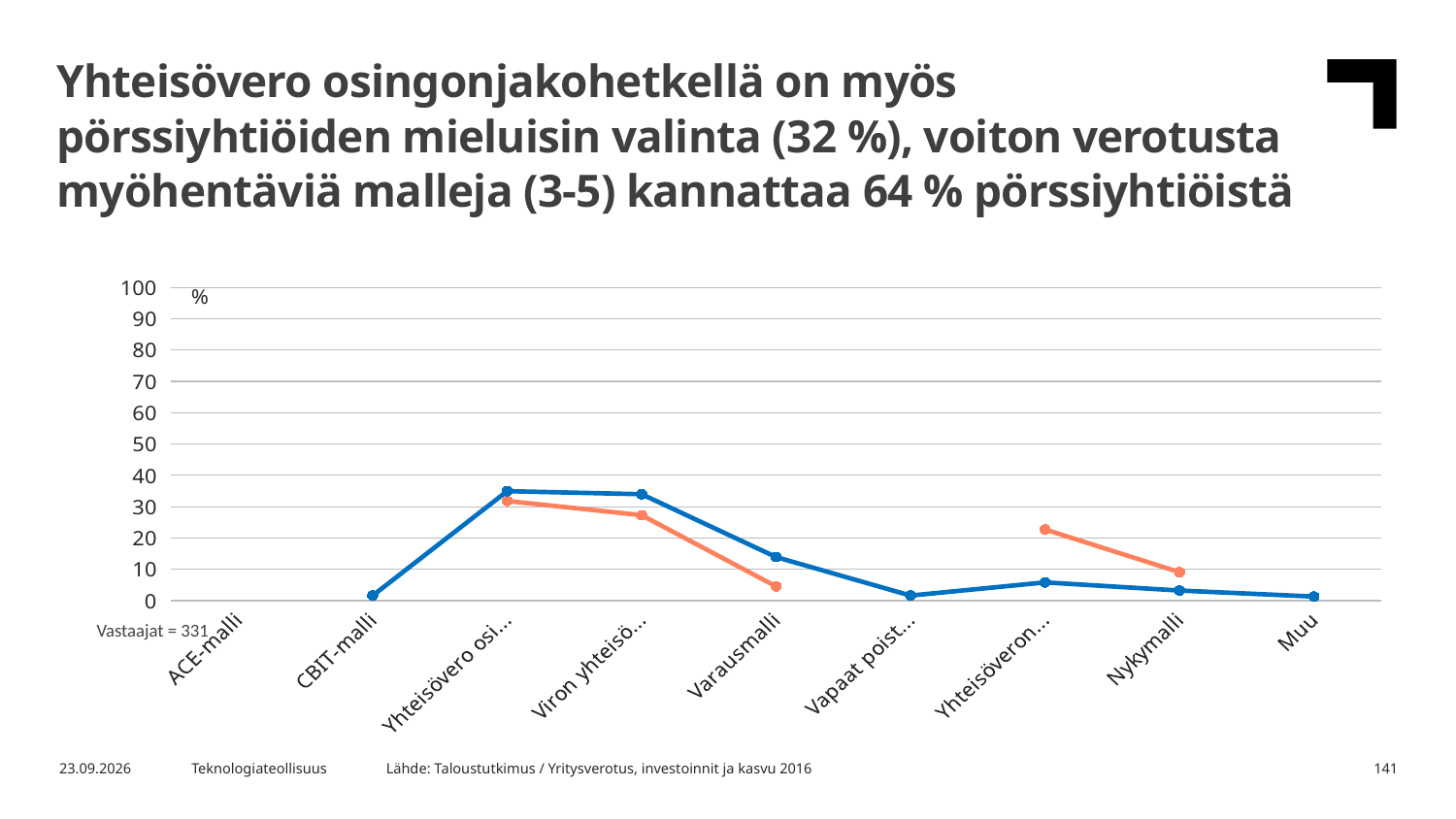
At which category does the orange line reach its highest value? Yhteisövero osi... Is the value of the orange line for Yhteisöveron... greater or less than 20? greater At Varausmalli, which line has the larger value, the blue line or the orange line? the blue line How many categories are shown on the x axis of the chart? 9 Is the value of the blue line for Varausmalli greater or less than 20? less Which is larger for the blue line: the value for Varausmalli or the value for Nykymalli? Varausmalli What kind of chart is shown on the slide? line chart Is the value of the orange line for Viron yhteisö... greater or less than 30? less At Yhteisöveron..., which line has the larger value, the blue line or the orange line? the orange line Does the blue line rise or fall from Viron yhteisö... to Vapaat poist...? fall What unit is shown at the top of the y axis of the chart? %